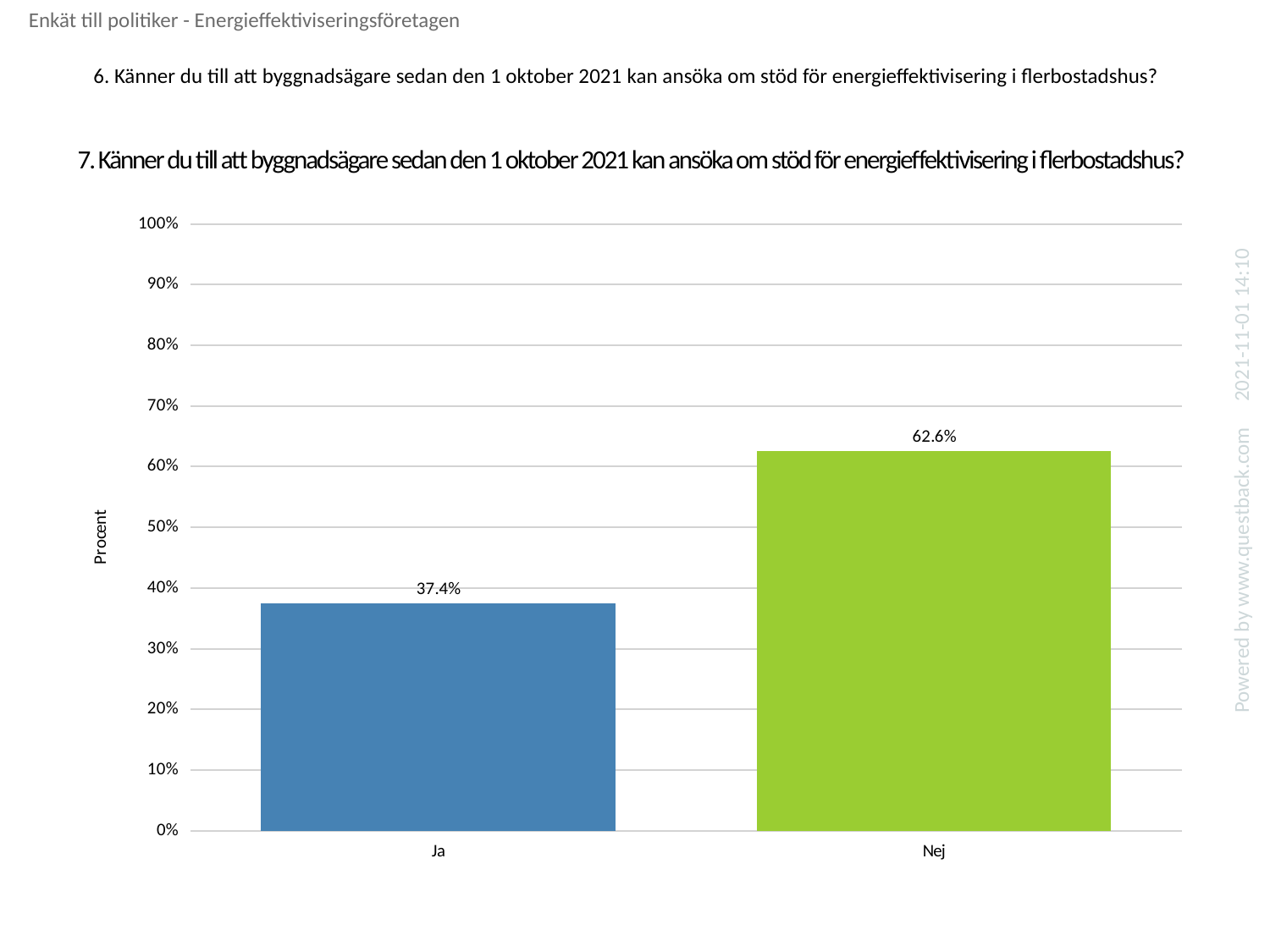
How many categories are shown on the x axis? 2 What colour is the bar for "Nej"? green What is the label of the y axis? Procent Which category has the highest value? Nej Which is larger, the value for "Ja" or the value for "Nej"? Nej What is the value for "Ja"? 37.4% Which category has the lowest value? Ja What is the difference between the values for "Nej" and "Ja"? 25.2% What kind of chart is shown on the slide? bar chart Is the value for "Nej" greater or less than 60%? greater Is the value for "Ja" greater or less than 40%? less What is the value for "Nej"? 62.6%